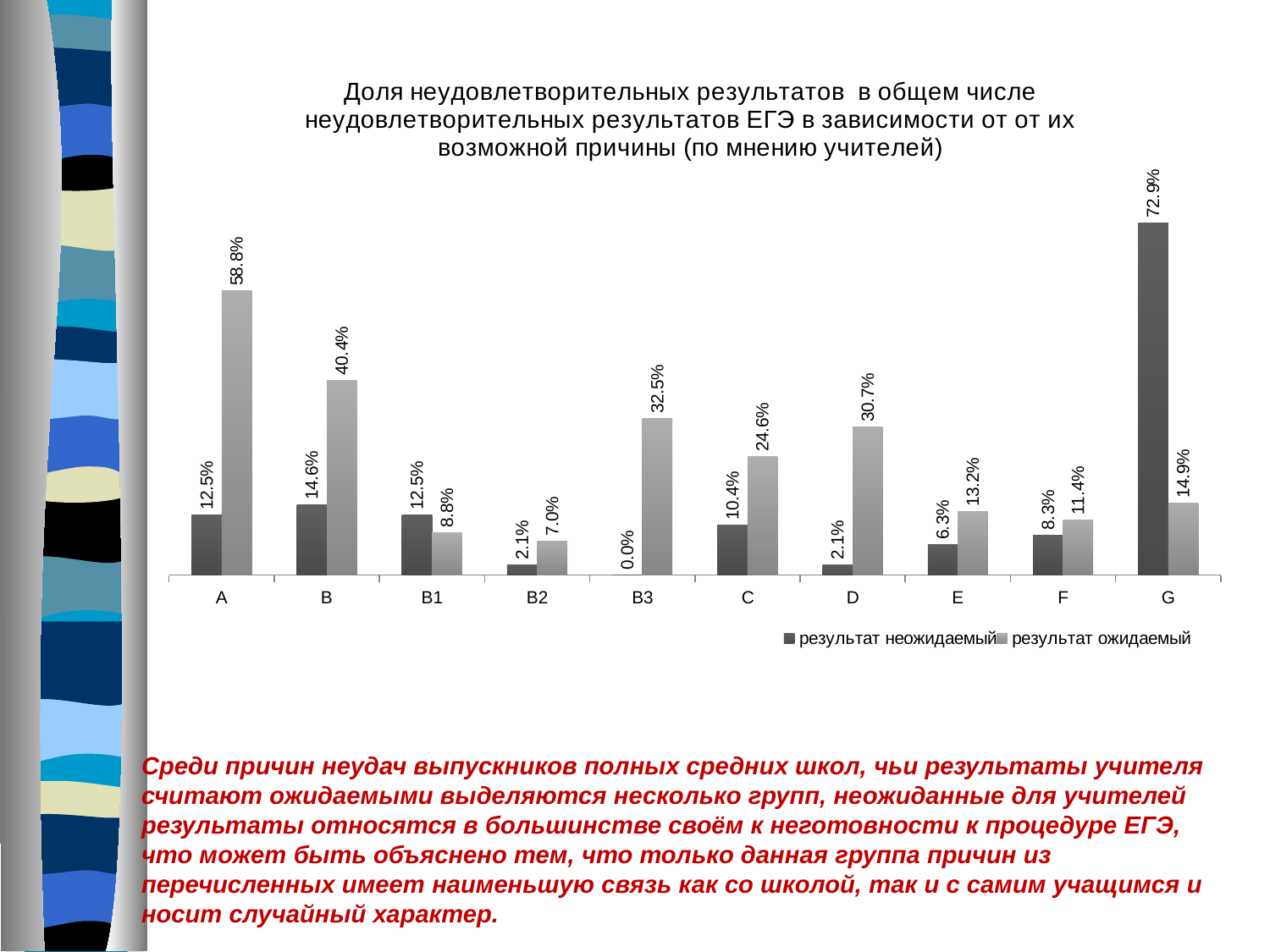
What is the value of 'результат ожидаемый' for category A? 58.8% What is the value of 'результат ожидаемый' for category C? 24.6% Which category has the highest value for 'результат неожидаемый'? G Which category has the highest value for 'результат ожидаемый'? A How many categories are shown on the x axis? 10 What is the difference between 'результат ожидаемый' and 'результат неожидаемый' for category D? 28.6% Which category has the lowest value for 'результат неожидаемый'? B3 For category B1, which series has the larger value: 'результат неожидаемый' or 'результат ожидаемый'? результат неожидаемый What kind of chart is shown on the slide? bar chart What is the value of 'результат неожидаемый' for category G? 72.9% What is the value of 'результат неожидаемый' for category B3? 0.0% How many series does the legend list? 2